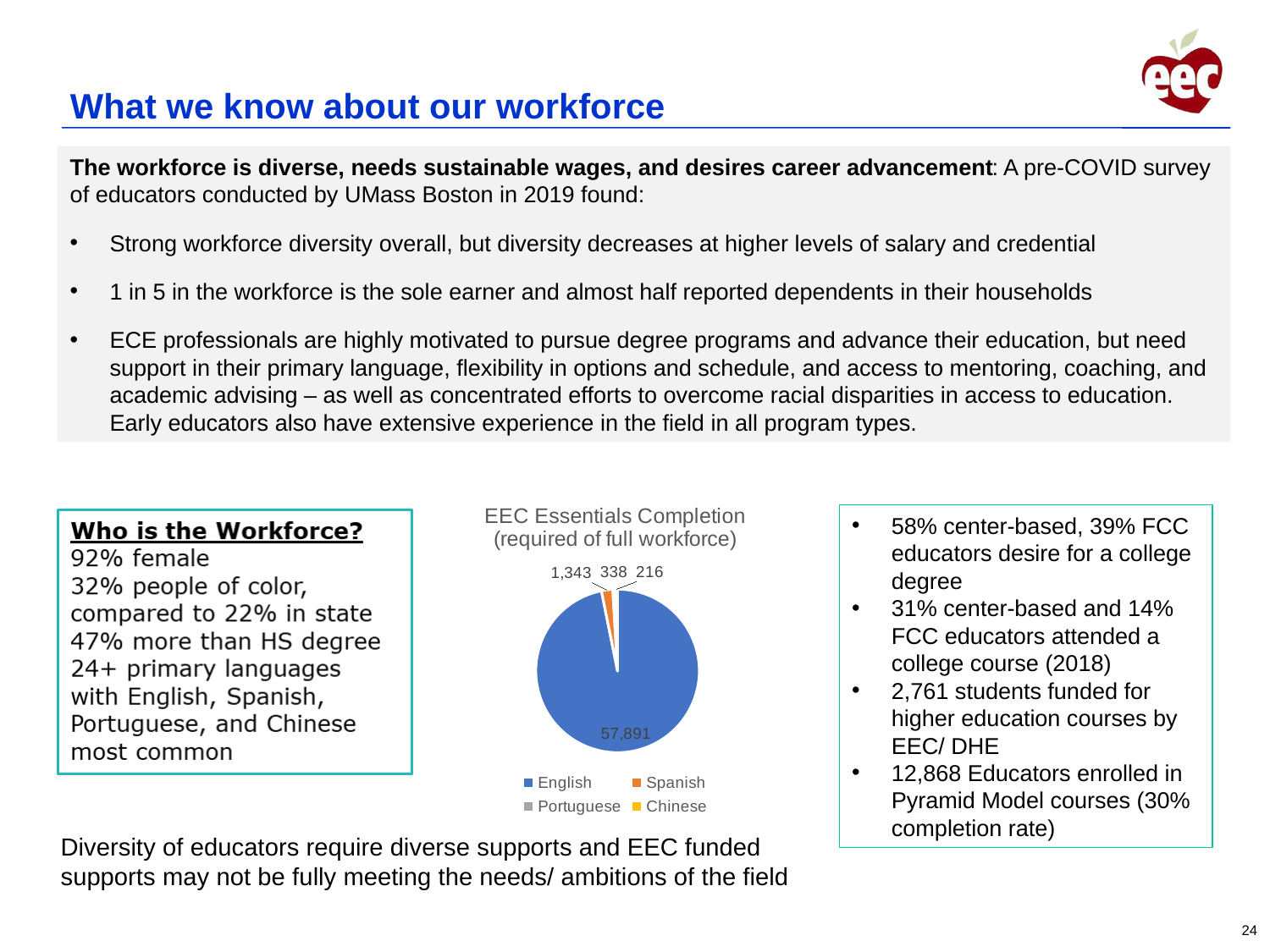
Which language has the smallest slice in the EEC Essentials Completion pie chart? Chinese Which language has the largest slice in the EEC Essentials Completion pie chart? English What colour represents English in the EEC Essentials Completion pie chart? blue In the EEC Essentials Completion pie chart, what is the difference between the English value and the Spanish value? 56,548 How many categories does the legend of the EEC Essentials Completion pie chart list? 4 In the EEC Essentials Completion pie chart, what is the value for Spanish? 1,343 In the EEC Essentials Completion pie chart, what is the value for English? 57,891 In the EEC Essentials Completion pie chart, what is the value for Chinese? 216 In the EEC Essentials Completion pie chart, what is the value for Portuguese? 338 In the EEC Essentials Completion pie chart, which is larger, the value for Spanish or the value for Portuguese? Spanish What kind of chart is shown under the heading "EEC Essentials Completion"? pie chart What is the subtitle shown in parentheses under the EEC Essentials Completion chart title? (required of full workforce)